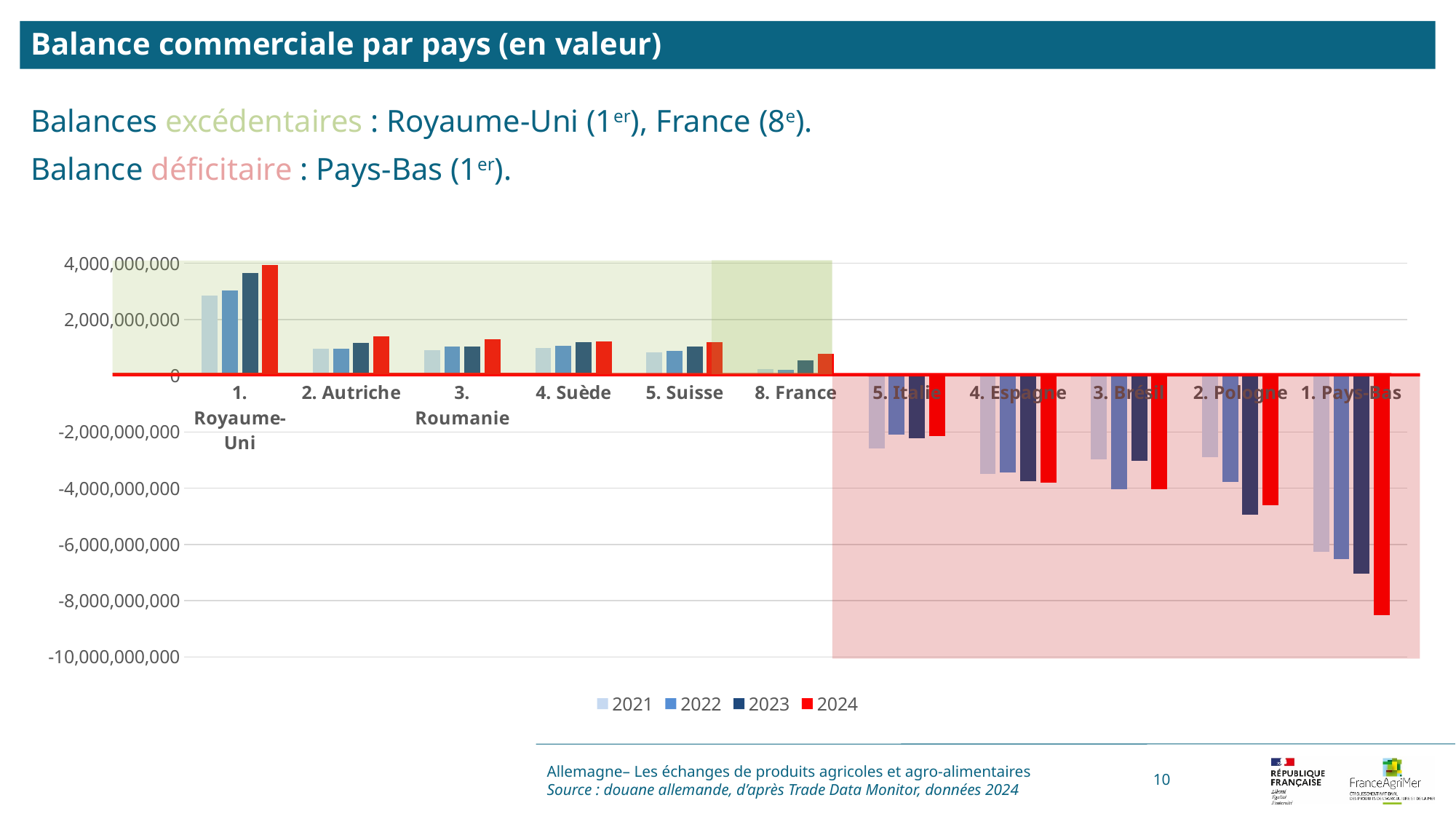
How many series does the chart legend list? 4 What kind of chart is shown on the slide? bar chart Do the values for 1. Royaume-Uni rise or fall from 2021 to 2024? rise Which country has the lowest 2024 value in the chart? 1. Pays-Bas Which country has the highest 2024 value in the chart? 1. Royaume-Uni Which is larger, the 2024 value for 1. Royaume-Uni or the 2024 value for 2. Autriche? 1. Royaume-Uni Is the 2024 value for 1. Pays-Bas greater or less than -8,000,000,000? less What is the title of the slide containing the chart? Balance commerciale par pays (en valeur) How many countries are shown on the x axis of the chart? 11 Is the 2024 value for 1. Royaume-Uni greater or less than 2,000,000,000? greater Is the 2024 value for 2. Pologne greater or less than -4,000,000,000? less Do the values for 1. Pays-Bas rise or fall from 2021 to 2024? fall